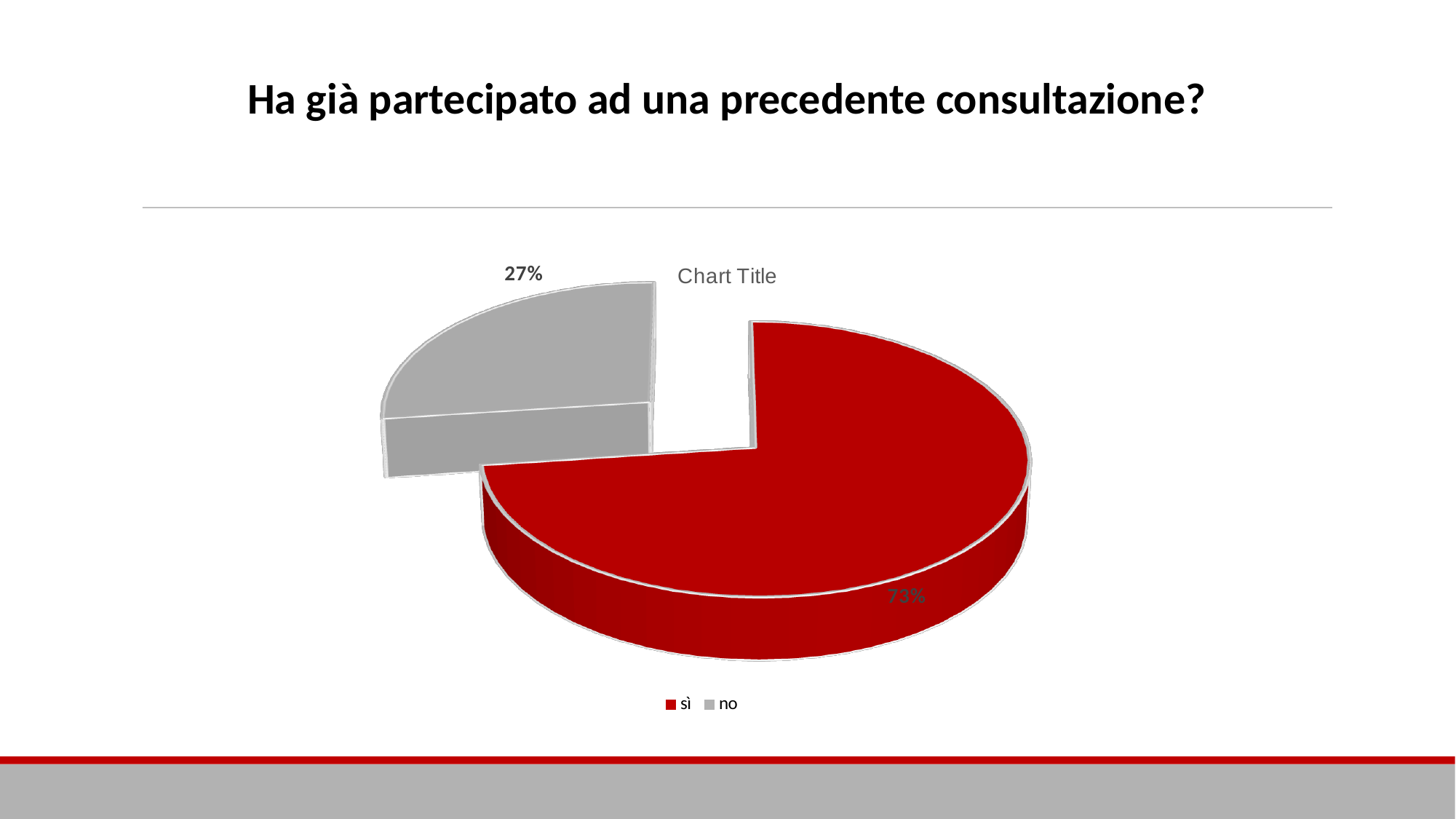
What share of the pie does the "no" slice represent? 27% What kind of chart is shown on the slide? pie chart What colour is the "sì" slice? red What is the title of the slide? Ha già partecipato ad una precedente consultazione? How many slices does the pie chart have? 2 What share of the pie does the "sì" slice represent? 73% Which slice is the smallest in the pie chart? no Which is larger, the "sì" slice or the "no" slice? sì How many entries does the legend list? 2 Which slice is the largest in the pie chart? sì What is the difference in percentage points between the "sì" and "no" slices? 46